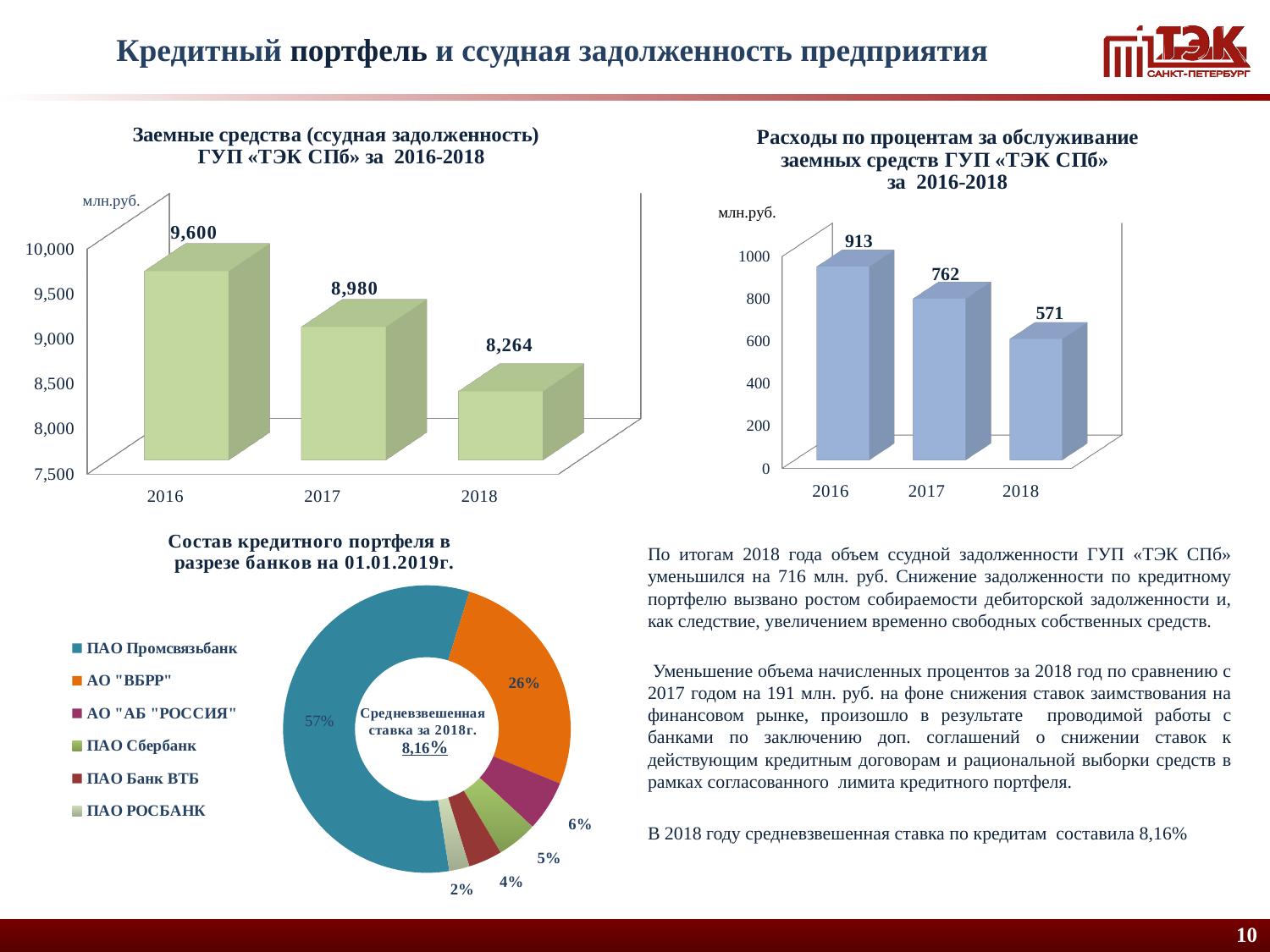
In the chart 'Заемные средства (ссудная задолженность) ГУП «ТЭК СПб» за 2016-2018', what is the value for 2016? 9,600 In the chart 'Расходы по процентам за обслуживание заемных средств ГУП «ТЭК СПб» за 2016-2018', which year has the highest value? 2016 In the chart 'Заемные средства (ссудная задолженность) ГУП «ТЭК СПб» за 2016-2018', do the values rise or fall from 2016 to 2018? fall In the chart 'Заемные средства (ссудная задолженность) ГУП «ТЭК СПб» за 2016-2018', what is the value for 2018? 8,264 In the chart 'Расходы по процентам за обслуживание заемных средств ГУП «ТЭК СПб» за 2016-2018', what is the value for 2017? 762 In the chart 'Расходы по процентам за обслуживание заемных средств ГУП «ТЭК СПб» за 2016-2018', how many years are shown? 3 In the chart 'Заемные средства (ссудная задолженность) ГУП «ТЭК СПб» за 2016-2018', what is the difference between the 2016 and 2017 values? 620 What kind of chart is 'Состав кредитного портфеля в разрезе банков на 01.01.2019г.'? pie (donut) chart In the chart 'Заемные средства (ссудная задолженность) ГУП «ТЭК СПб» за 2016-2018', which year has the lowest value? 2018 How many entries does the legend of the chart 'Состав кредитного портфеля в разрезе банков на 01.01.2019г.' list? 6 In the chart 'Расходы по процентам за обслуживание заемных средств ГУП «ТЭК СПб» за 2016-2018', what is the difference between the 2017 and 2018 values? 191 In the chart 'Состав кредитного портфеля в разрезе банков на 01.01.2019г.', what share does ПАО Промсвязьбанк have? 57%